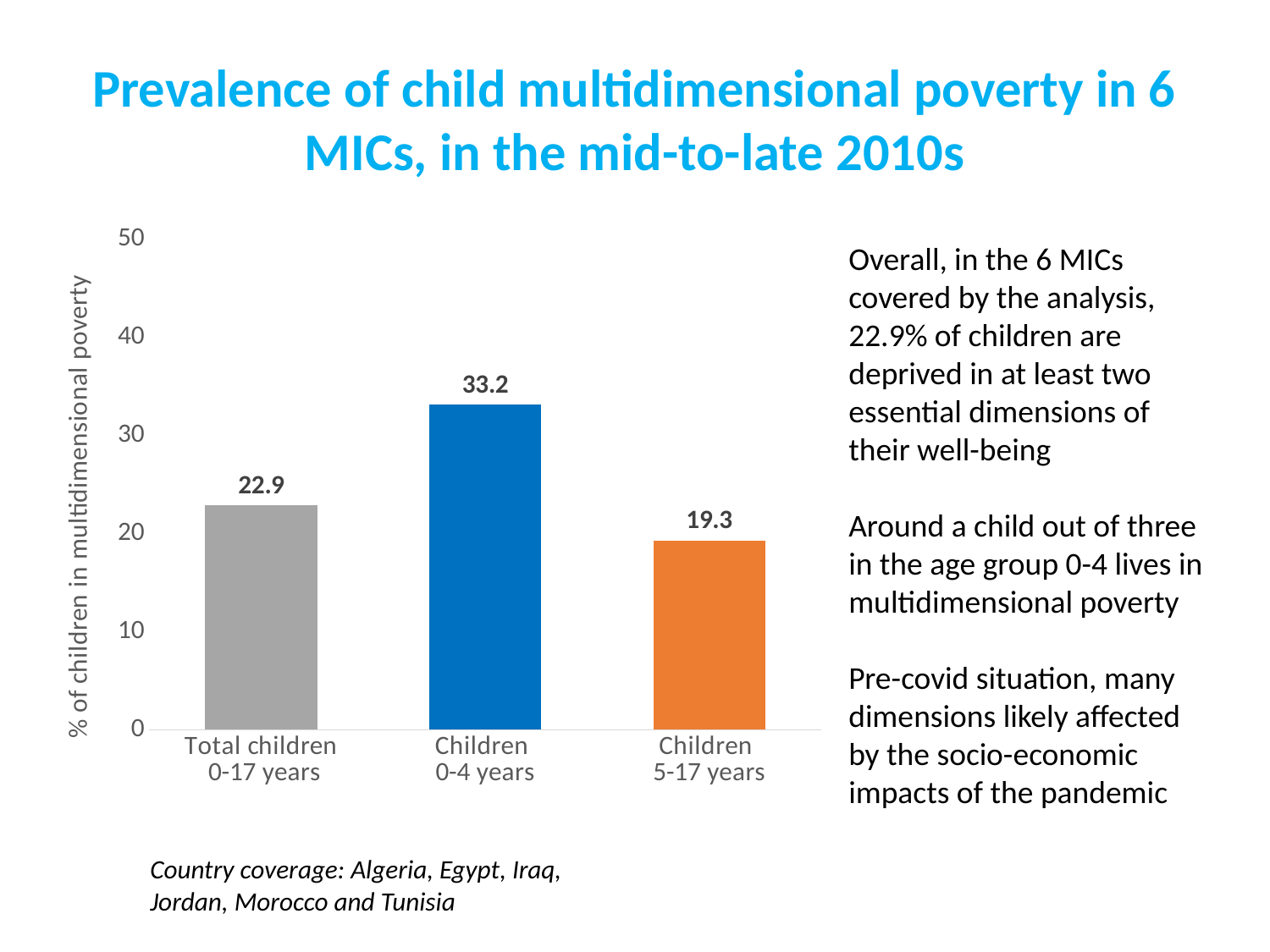
What is the value for Total children 0-17 years? 22.9 What is the value for Children 0-4 years? 33.2 What is the value for Children 5-17 years? 19.3 Which is larger, the value for Total children 0-17 years or Children 5-17 years? Total children 0-17 years What is the label of the vertical axis? % of children in multidimensional poverty Which category has the lowest value? Children 5-17 years What is the difference between the values for Children 0-4 years and Total children 0-17 years? 10.3 How many categories are shown on the chart? 3 Is the value for Children 0-4 years greater or less than 30? greater What is the difference between the values for Children 0-4 years and Children 5-17 years? 13.9 Which category has the highest value? Children 0-4 years What kind of chart is shown on the slide? bar chart